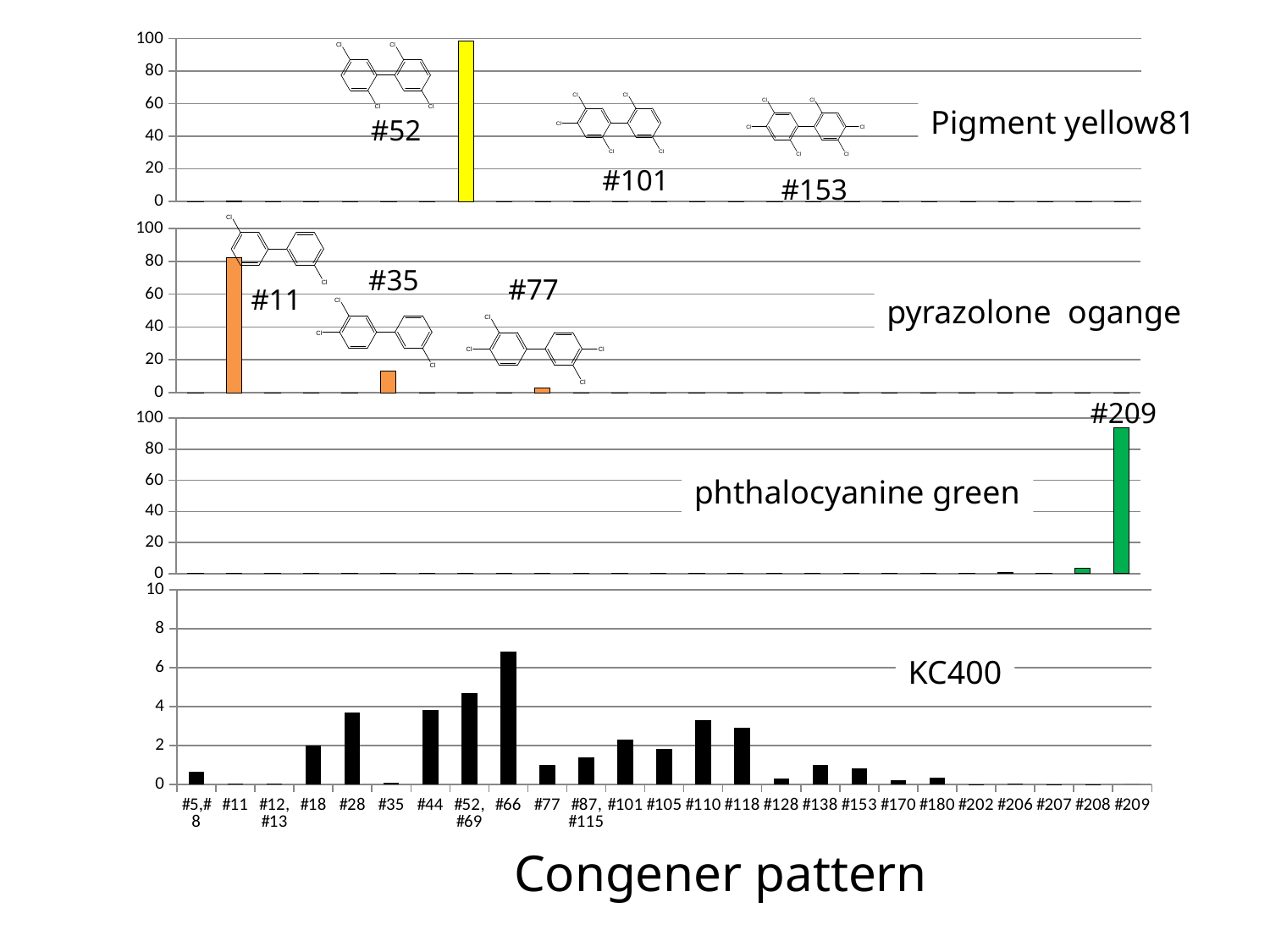
In the KC400 chart, is the value for #66 greater or less than 6? greater How many congener categories are listed along the x axis of the KC400 chart? 25 In the pyrazolone orange chart, which congener has the highest bar? #11 In the pyrazolone orange chart, is the value for #35 greater or less than 20? less In the KC400 chart, is the value for #110 greater or less than 4? less What colour are the bars in the phthalocyanine green chart? green In the KC400 chart, which is larger, the value for #28 or the value for #77? #28 In the KC400 chart, which congener has the highest bar? #66 In the Pigment yellow81 chart, which congener has the highest bar? #52 What kind of chart is the KC400 chart? bar chart